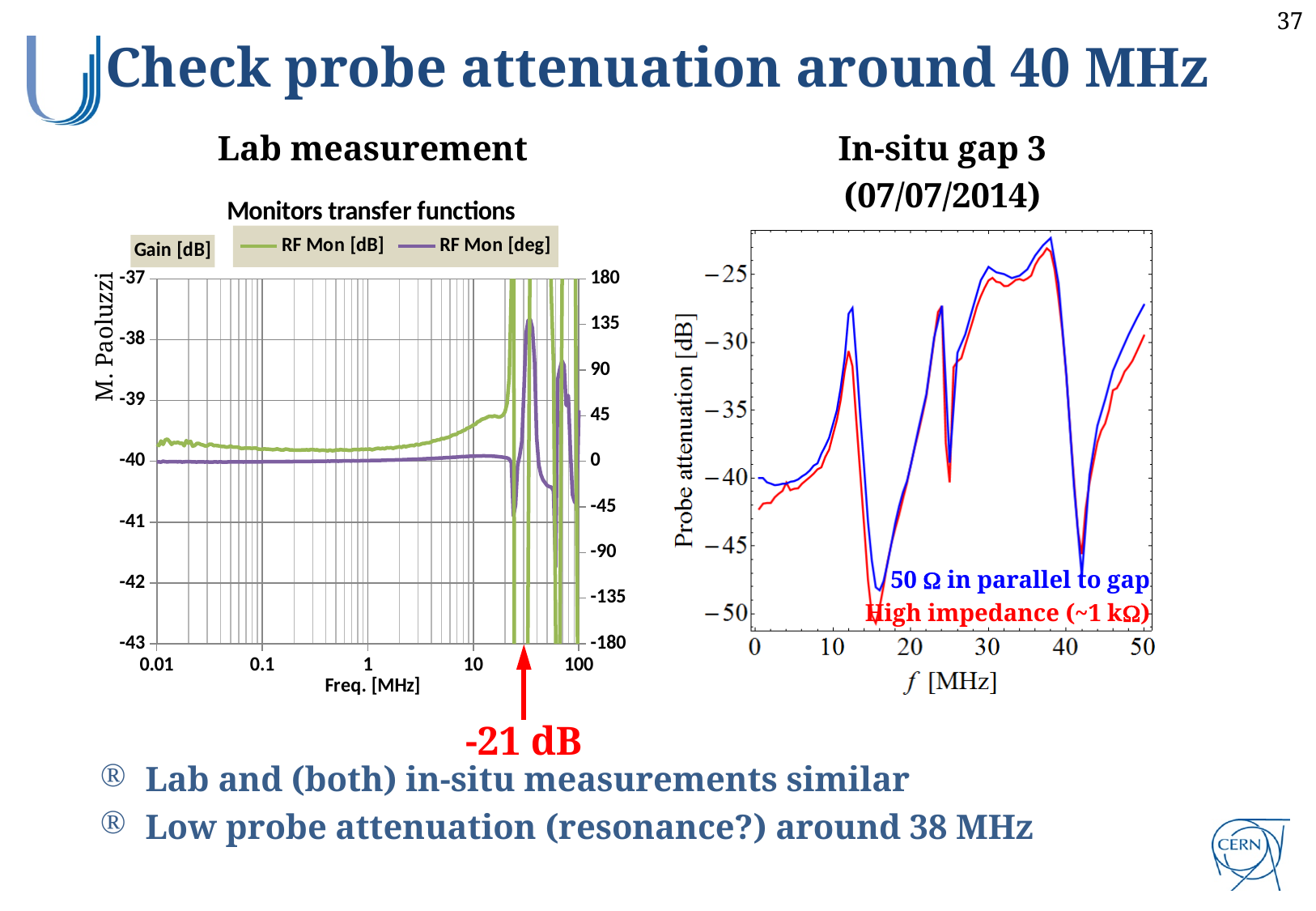
What kind of chart is the 'In-situ gap 3 (07/07/2014)' chart on the right? line chart How many series does the legend of the 'Monitors transfer functions' chart list? 2 How many series are plotted on the 'In-situ gap 3 (07/07/2014)' chart? 2 On the 'In-situ gap 3 (07/07/2014)' chart, does the blue line rise or fall between 0 and 12 MHz? rise On the 'In-situ gap 3 (07/07/2014)' chart, is the probe attenuation of the blue line at 42 MHz greater or less than -45? less On the 'In-situ gap 3 (07/07/2014)' chart, which series is drawn in blue? 50 Ω in parallel to gap What kind of chart is the 'Monitors transfer functions' chart on the left? line chart On the 'Monitors transfer functions' chart, is the RF Mon [dB] value at 1 MHz greater or less than -39? less On the 'In-situ gap 3 (07/07/2014)' chart, is the probe attenuation of the blue line at 38 MHz greater or less than -25? greater On the 'Monitors transfer functions' chart, what value does the red arrow annotation below the x axis indicate? -21 dB What are the two legend entries of the 'Monitors transfer functions' chart? RF Mon [dB] and RF Mon [deg]